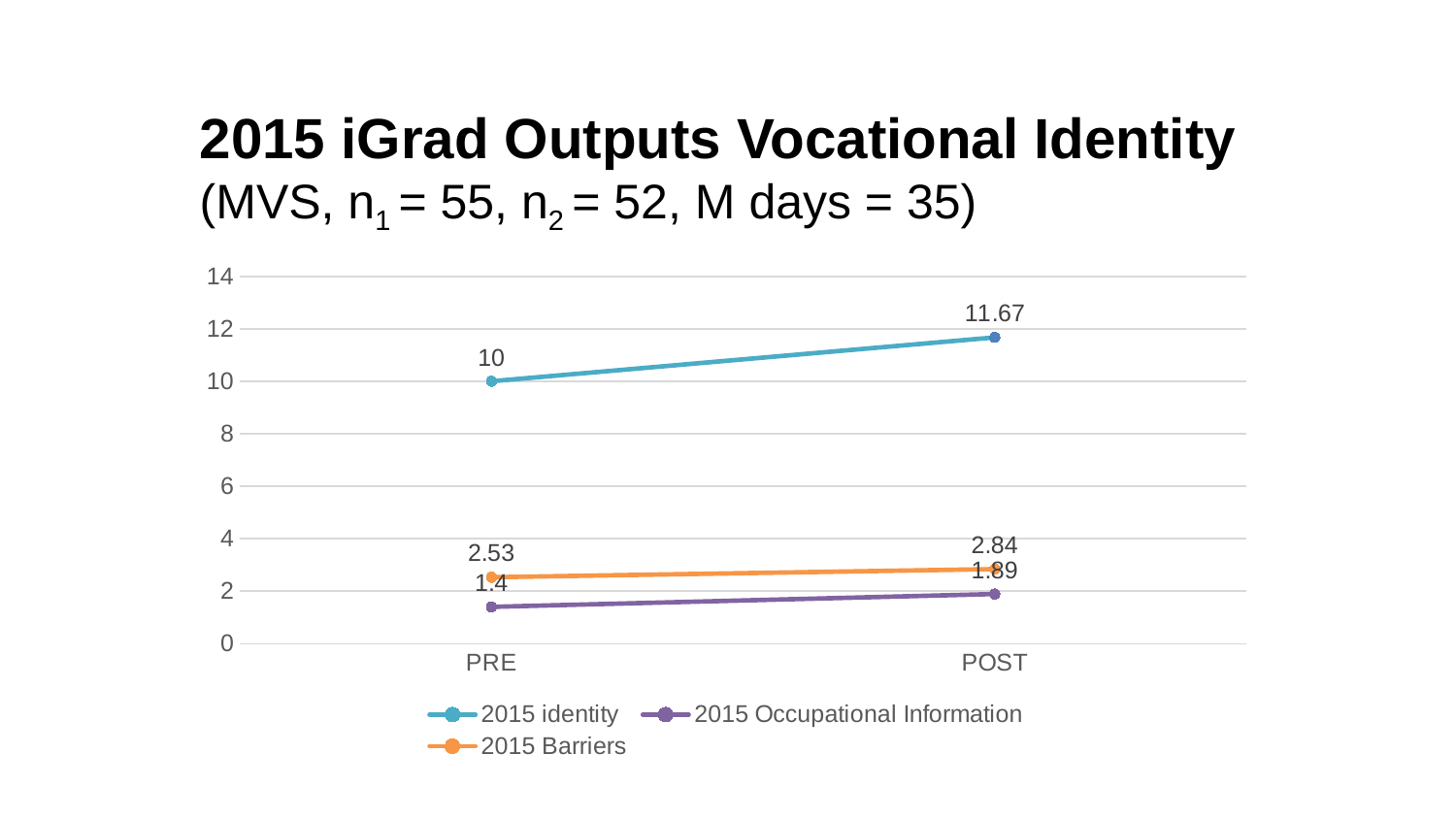
What is the value for 2015 identity at POST? 11.67 What is the value for 2015 Barriers at PRE? 2.53 What kind of chart is shown on the slide? Line chart Which series has the lowest value at PRE? 2015 Occupational Information What is the value for 2015 Occupational Information at POST? 1.89 How many series does the legend list? 3 How many categories are on the x axis? 2 Which series has the highest value at POST? 2015 identity Does the 2015 Occupational Information series rise or fall from PRE to POST? Rise Which is larger at POST: 2015 Barriers or 2015 Occupational Information? 2015 Barriers What is the difference between the POST and PRE values for 2015 identity? 1.67 What is the value for 2015 identity at PRE? 10